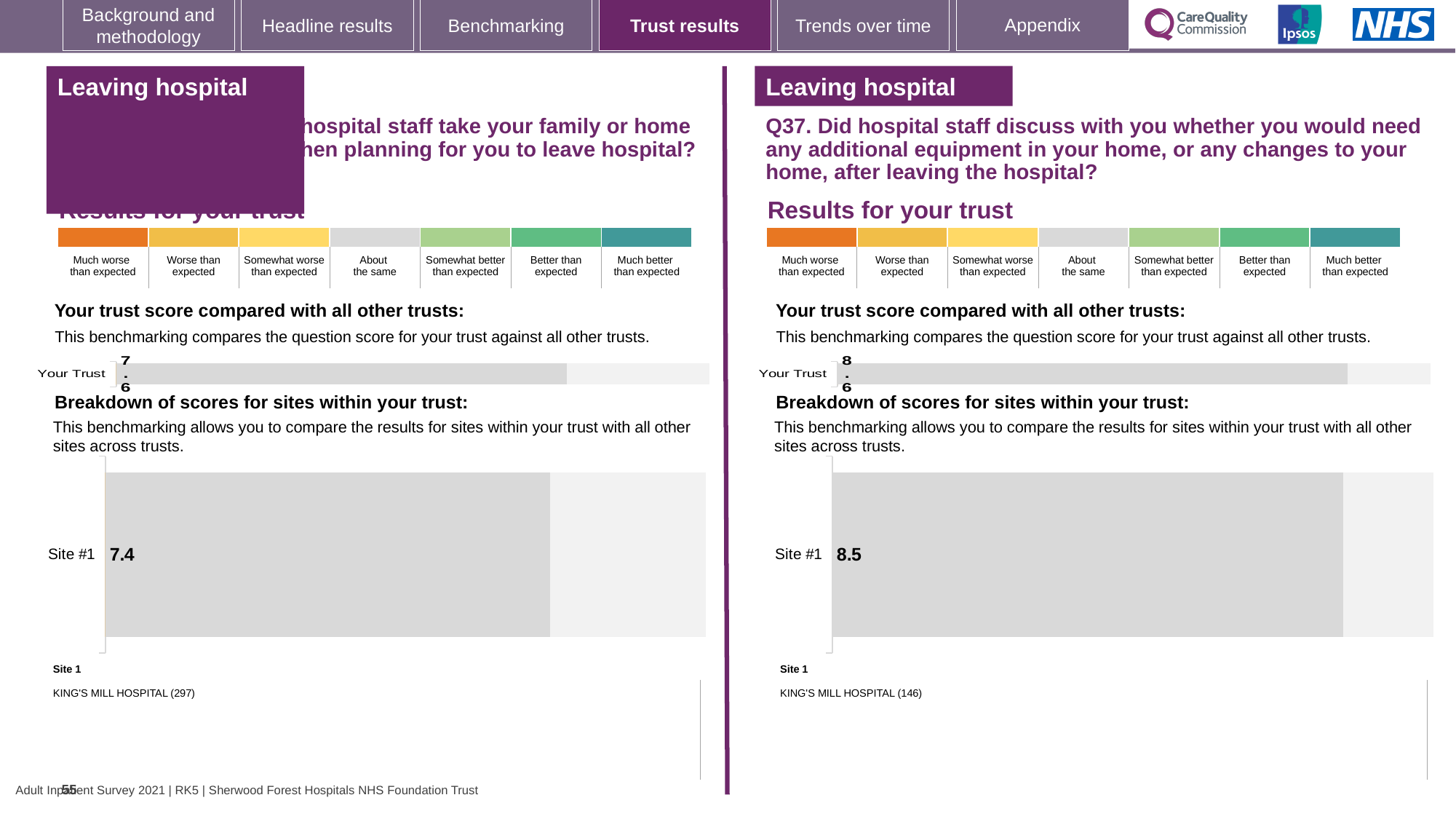
On the right half of the slide (Q37), what score is shown for Site #1 in the breakdown of scores for sites within your trust? 8.5 On the left half of the slide, what score is shown for Site #1 in the breakdown of scores for sites within your trust? 7.4 What type of chart is used to show the Site #1 score on the left half of the slide? Bar chart On the left half of the slide, what is the difference between the 'Your Trust' score and the Site #1 score? 0.2 Which site is listed as Site 1 in the site breakdown on the right half of the slide (Q37)? KING'S MILL HOSPITAL (146) What is the difference between the 'Your Trust' score on the right (Q37) and the 'Your Trust' score on the left? 1.0 Which has the higher 'Your Trust' score: the left chart or the Q37 chart on the right? Q37 chart on the right How many sites are shown in the site breakdown chart on the right half of the slide (Q37)? 1 On the right half of the slide (Q37), what is the 'Your Trust' score shown in the trust benchmarking bar? 8.6 How many categories are shown in the colour scale legend above 'Your trust score compared with all other trusts' on the right half of the slide? 7 On the left half of the slide, what is the 'Your Trust' score shown in the trust benchmarking bar? 7.6 On the right half of the slide (Q37), what is the difference between the 'Your Trust' score and the Site #1 score? 0.1